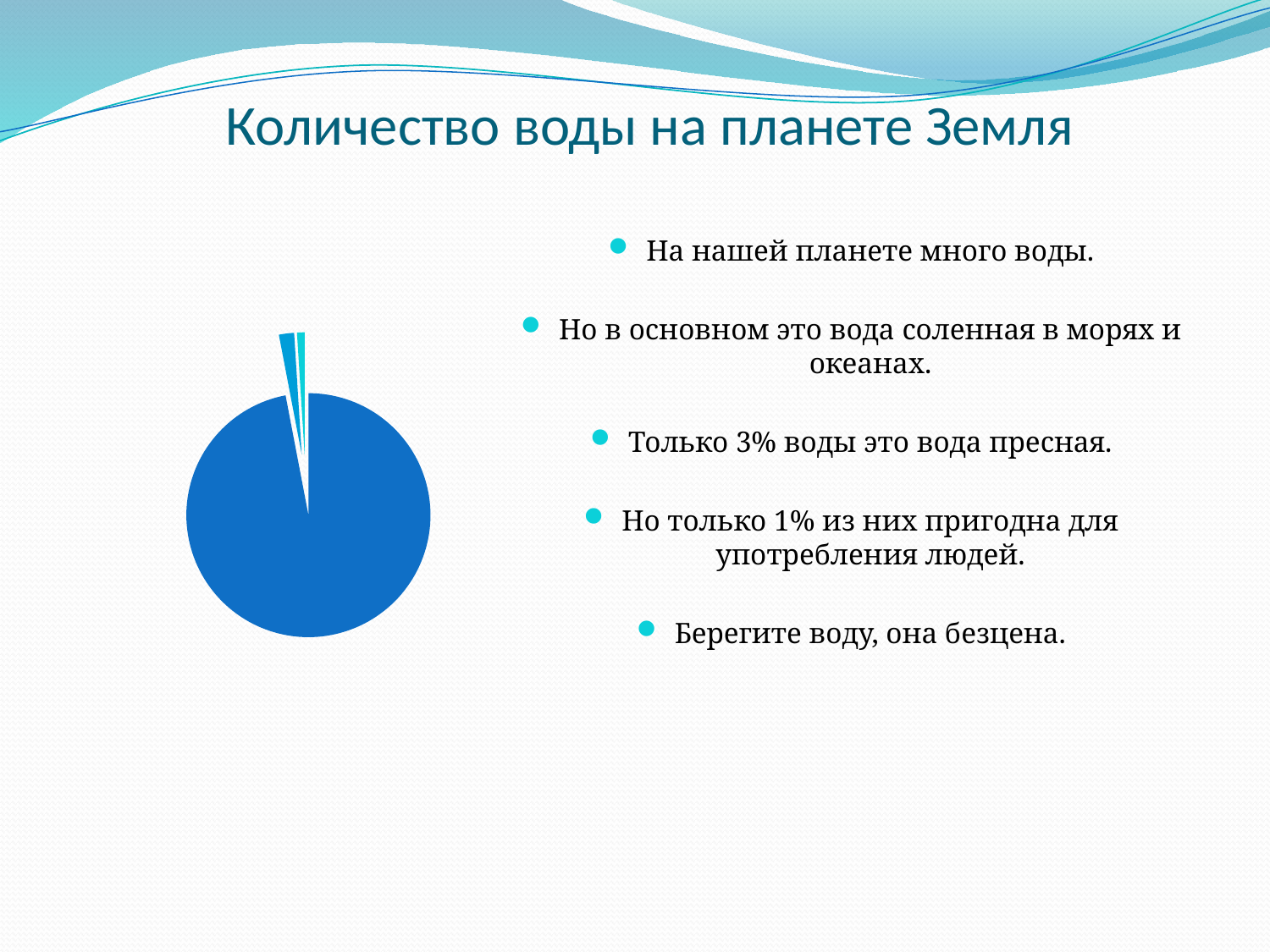
Does the pie chart have a legend? No What kind of chart is shown on the slide? pie chart Are any data labels printed on the pie chart? No How many slices does the pie chart have? 3 Which slice of the pie chart is the largest? the dark blue slice